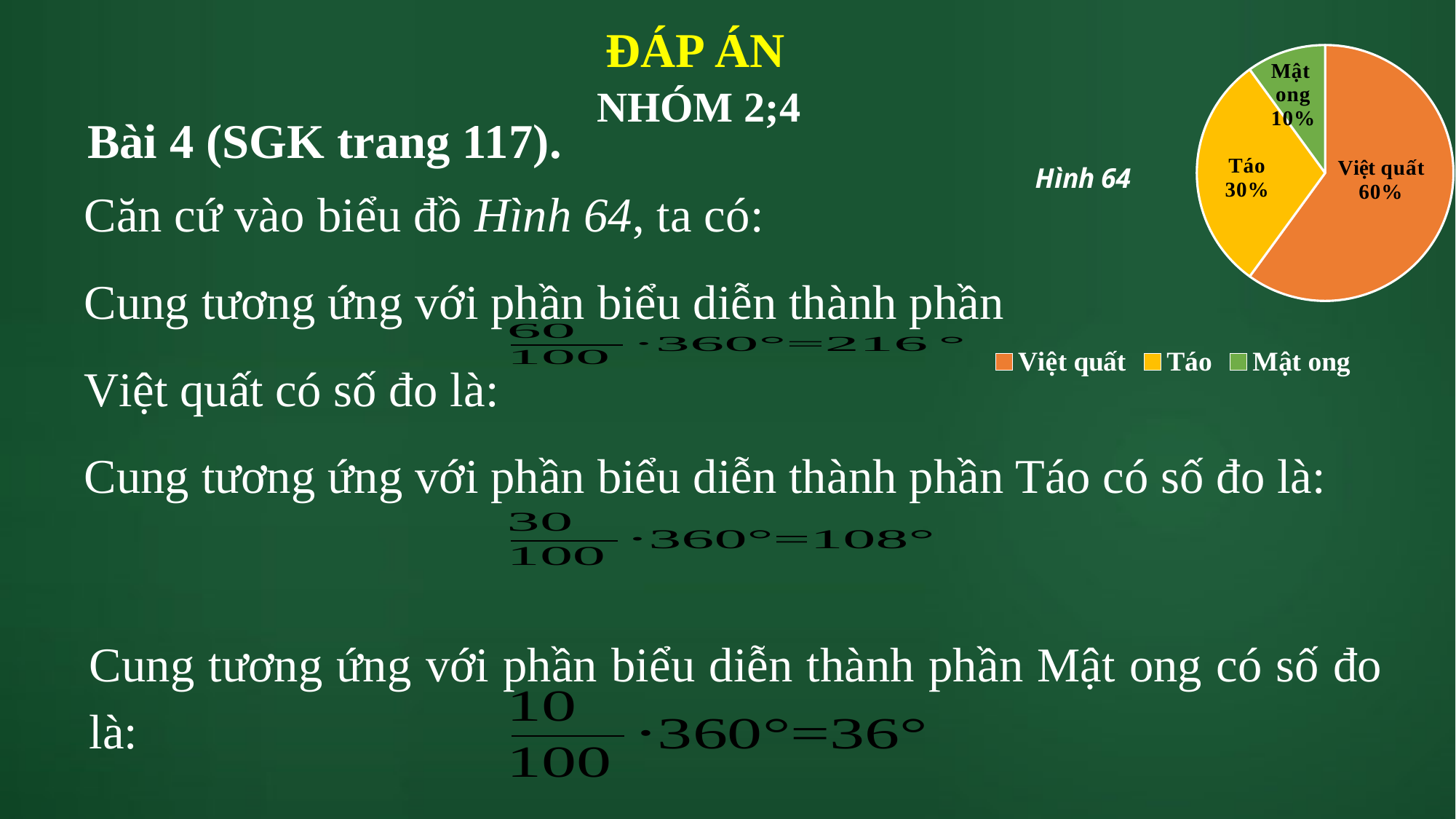
What share of the pie chart does Táo represent? 30% What share of the pie chart does Việt quất represent? 60% What colour is the Việt quất slice in the pie chart? Orange What is the figure label shown next to the pie chart? Hình 64 Which category has the smallest slice in the pie chart? Mật ong What is the difference in percentage points between the Táo and Mật ong slices? 20 What kind of chart is shown on the slide? Pie chart How many categories are shown in the pie chart? 3 What share of the pie chart does Mật ong represent? 10% What is the difference in percentage points between the Việt quất and Táo slices? 30 Which category has the largest slice in the pie chart? Việt quất Which slice is larger, Táo or Mật ong? Táo